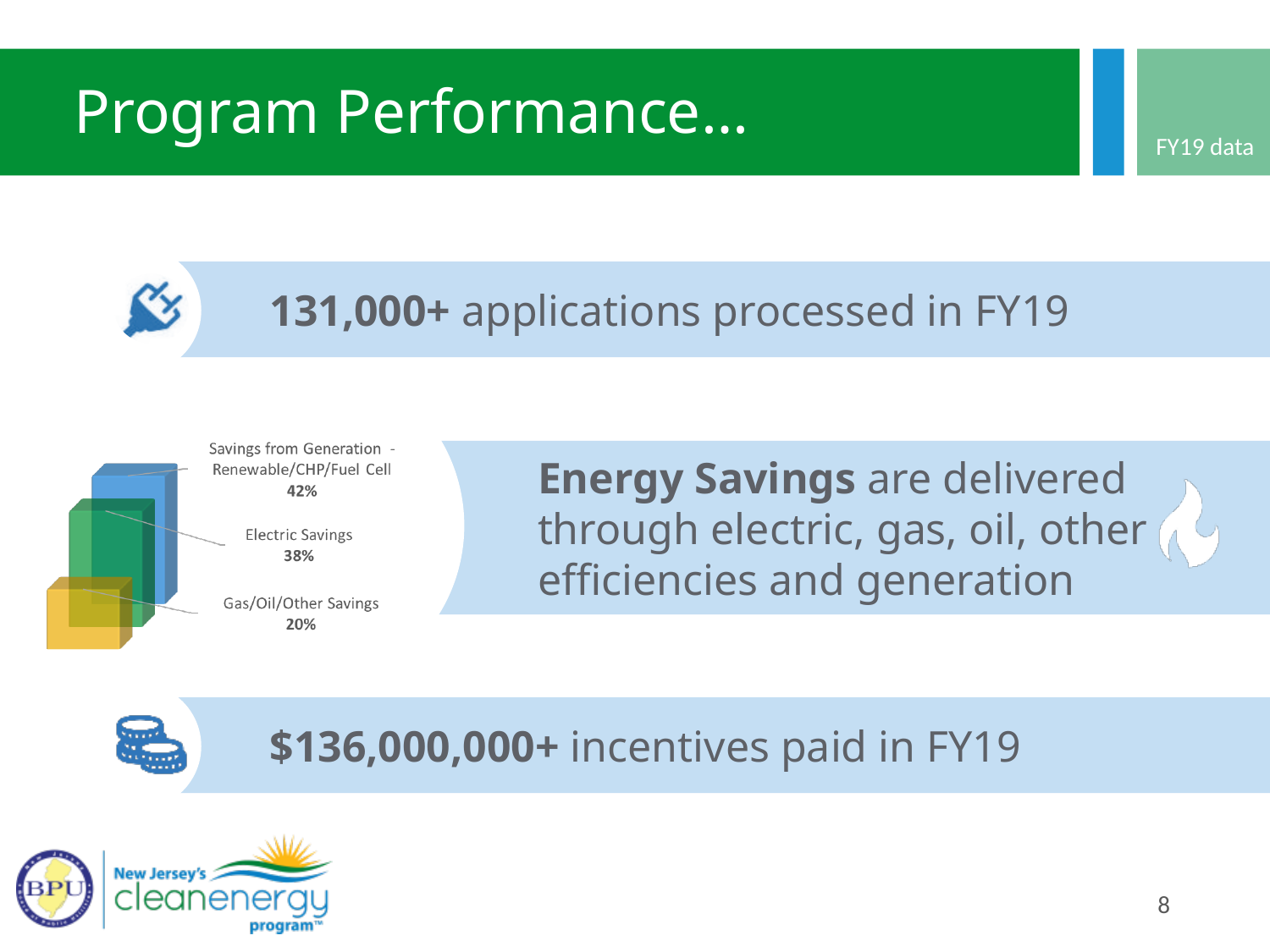
Which is larger, Electric Savings or Gas/Oil/Other Savings? Electric Savings What colour is the block representing Gas/Oil/Other Savings? Yellow How many savings categories are shown in the energy savings chart? 3 What percentage of energy savings comes from Gas/Oil/Other Savings? 20% What colour is the block representing Savings from Generation - Renewable/CHP/Fuel Cell? Blue What is the difference in percentage points between Electric Savings and Gas/Oil/Other Savings? 18 percentage points What percentage of energy savings comes from Savings from Generation - Renewable/CHP/Fuel Cell? 42% What do the three energy savings percentages add up to? 100% What is the difference in percentage points between Savings from Generation - Renewable/CHP/Fuel Cell and Electric Savings? 4 percentage points What percentage of energy savings comes from Electric Savings? 38% Which category accounts for the largest share of energy savings? Savings from Generation - Renewable/CHP/Fuel Cell Which category accounts for the smallest share of energy savings? Gas/Oil/Other Savings